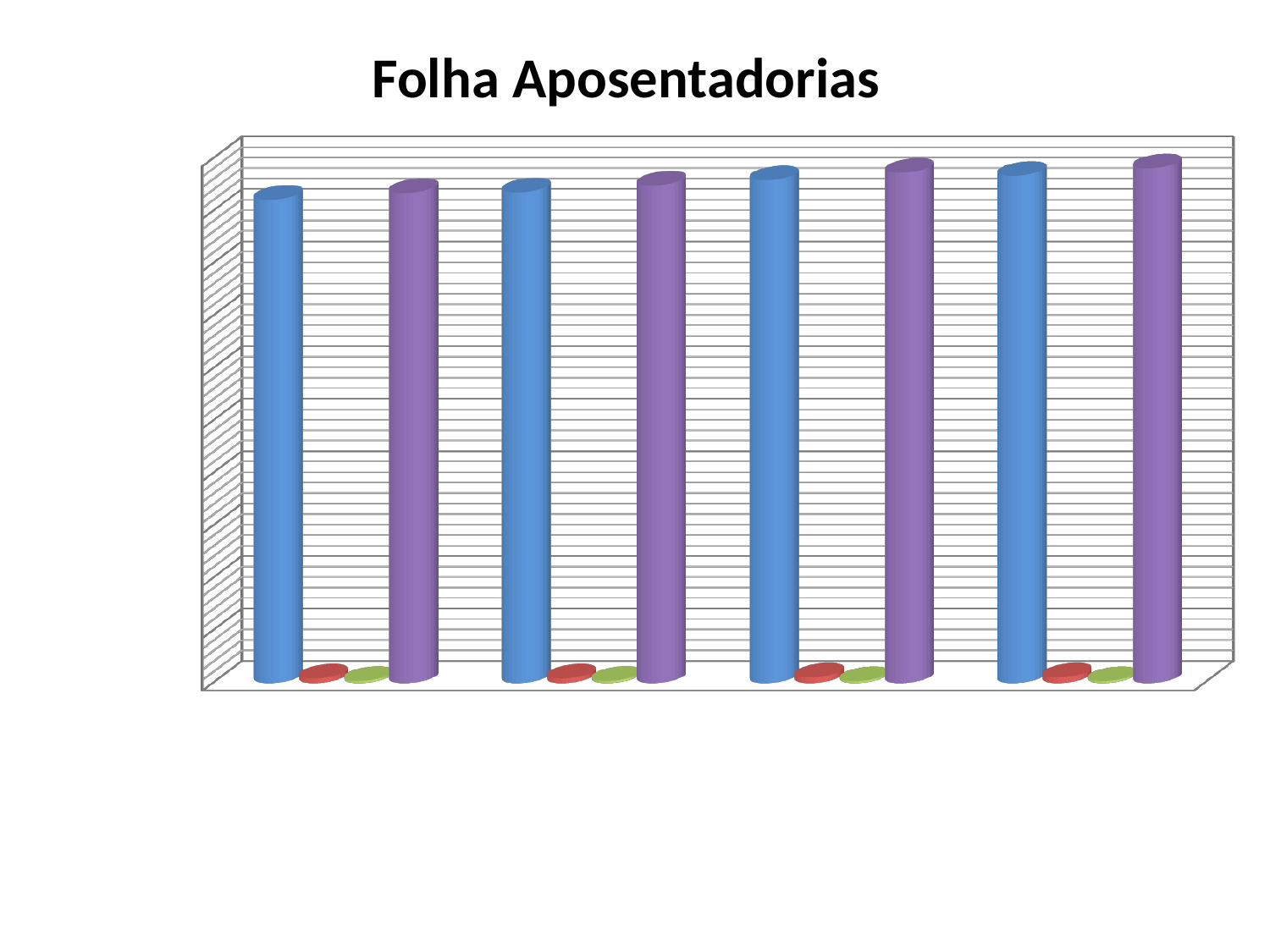
Which colour of bar is the tallest in the rightmost group? purple In the first group, which is taller, the blue bar or the red bar? the blue bar Do the purple bars rise or fall from left to right across the groups? rise In the last group, which is taller, the purple bar or the green bar? the purple bar Which two bar colours are close to zero in every group? red and green What is the title of the chart? Folha Aposentadorias Do the blue bars rise or fall from left to right across the groups? rise What kind of chart is shown on the slide? bar chart How many bars are there in each group of the chart? 4 How many groups of bars are plotted in the chart? 4